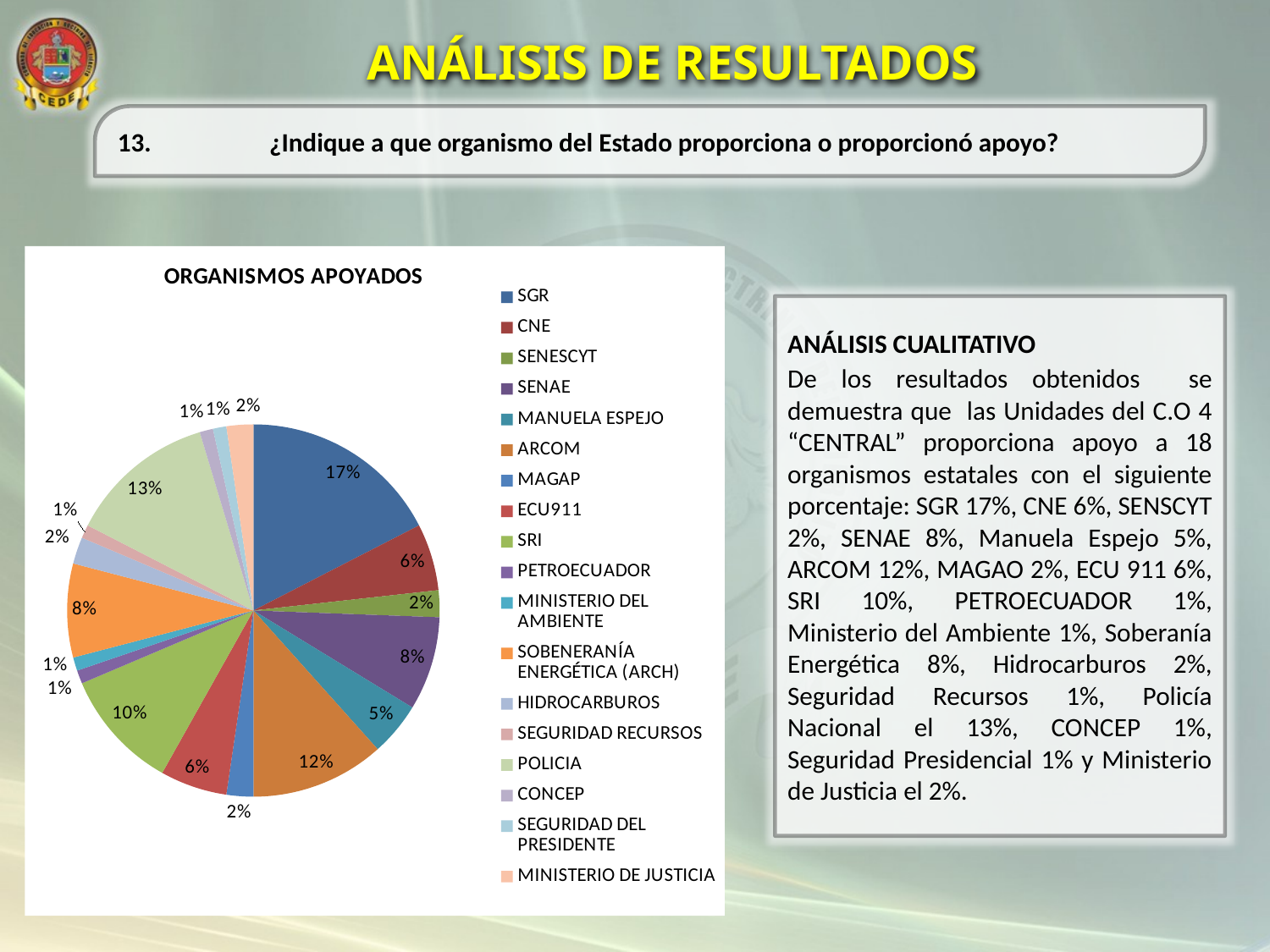
What is the title of the chart? ORGANISMOS APOYADOS Which organism has the largest slice of the pie? SGR Which is larger, the slice for SENAE or the slice for CNE? SENAE What percentage of the pie does MANUELA ESPEJO represent? 5% What percentage of the pie does SRI represent? 10% How many entries does the chart legend list? 18 What percentage of the pie does POLICIA represent? 13% What is the difference in percentage points between the SGR slice and the POLICIA slice? 4% What type of chart is shown on the slide? pie chart What is the difference in percentage points between the ARCOM slice and the SRI slice? 2%